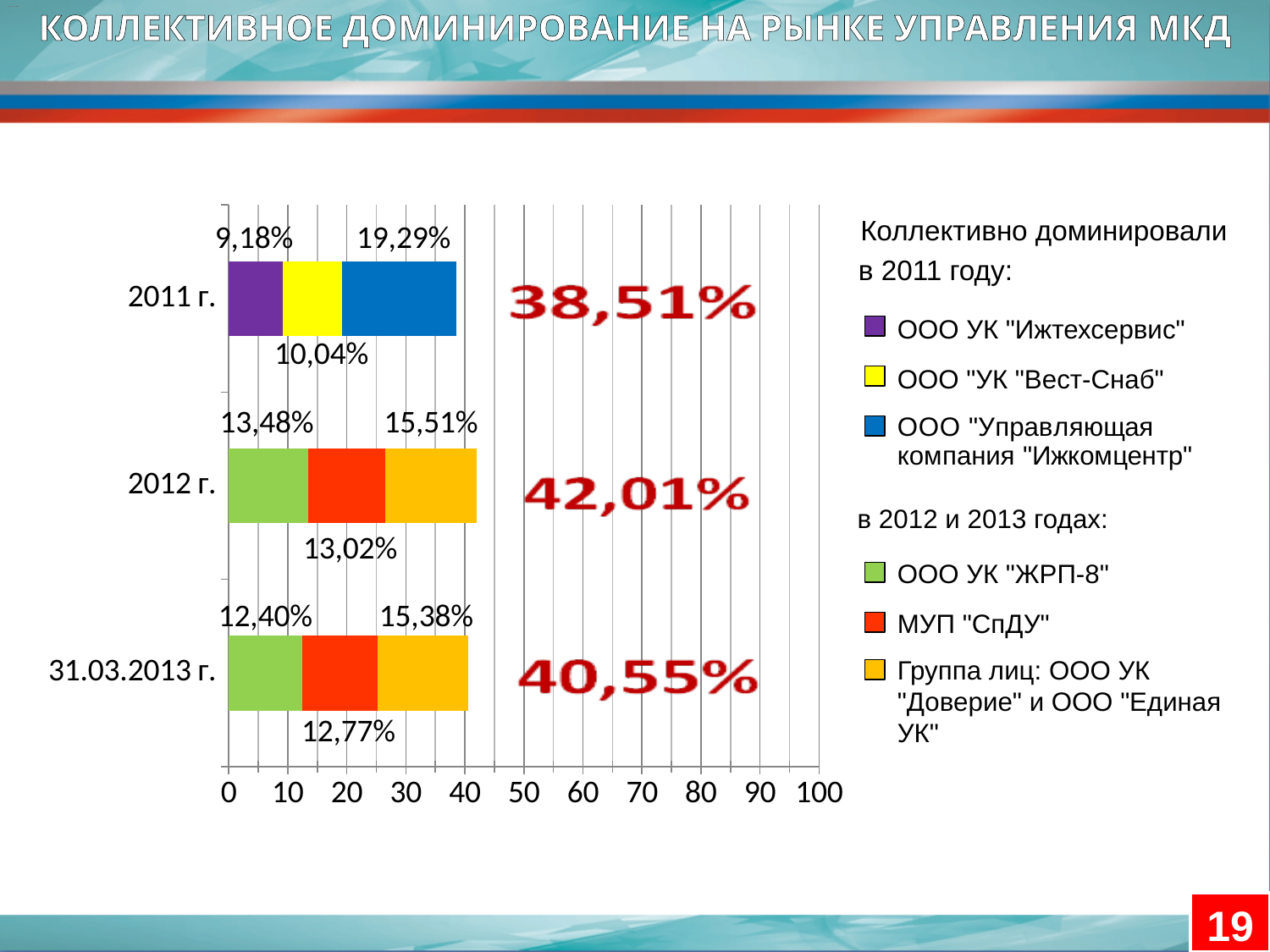
What is the total share of the stacked bar for 2011 г.? 38,51% How many categories (time periods) are plotted on the chart? 3 Which period has the lowest total collective share? 2011 г. What is the share of МУП "СпДУ" on 31.03.2013 г.? 12,77% What is the share of ООО УК "ЖРП-8" in 2012 г.? 13,48% What is the share of ООО "Управляющая компания "Ижкомцентр" in 2011 г.? 19,29% What is the total share of the stacked bar for 31.03.2013 г.? 40,55% What kind of chart is shown on the slide? stacked bar chart Which period has the highest total collective share? 2012 г. What is the total share of the stacked bar for 2012 г.? 42,01% What is the difference between the total share in 2012 г. and in 2011 г.? 3,50% Which is larger: the share of ООО УК "Ижтехсервис" in 2011 г. or the share of ООО "УК "Вест-Снаб" in 2011 г.? ООО "УК "Вест-Снаб"